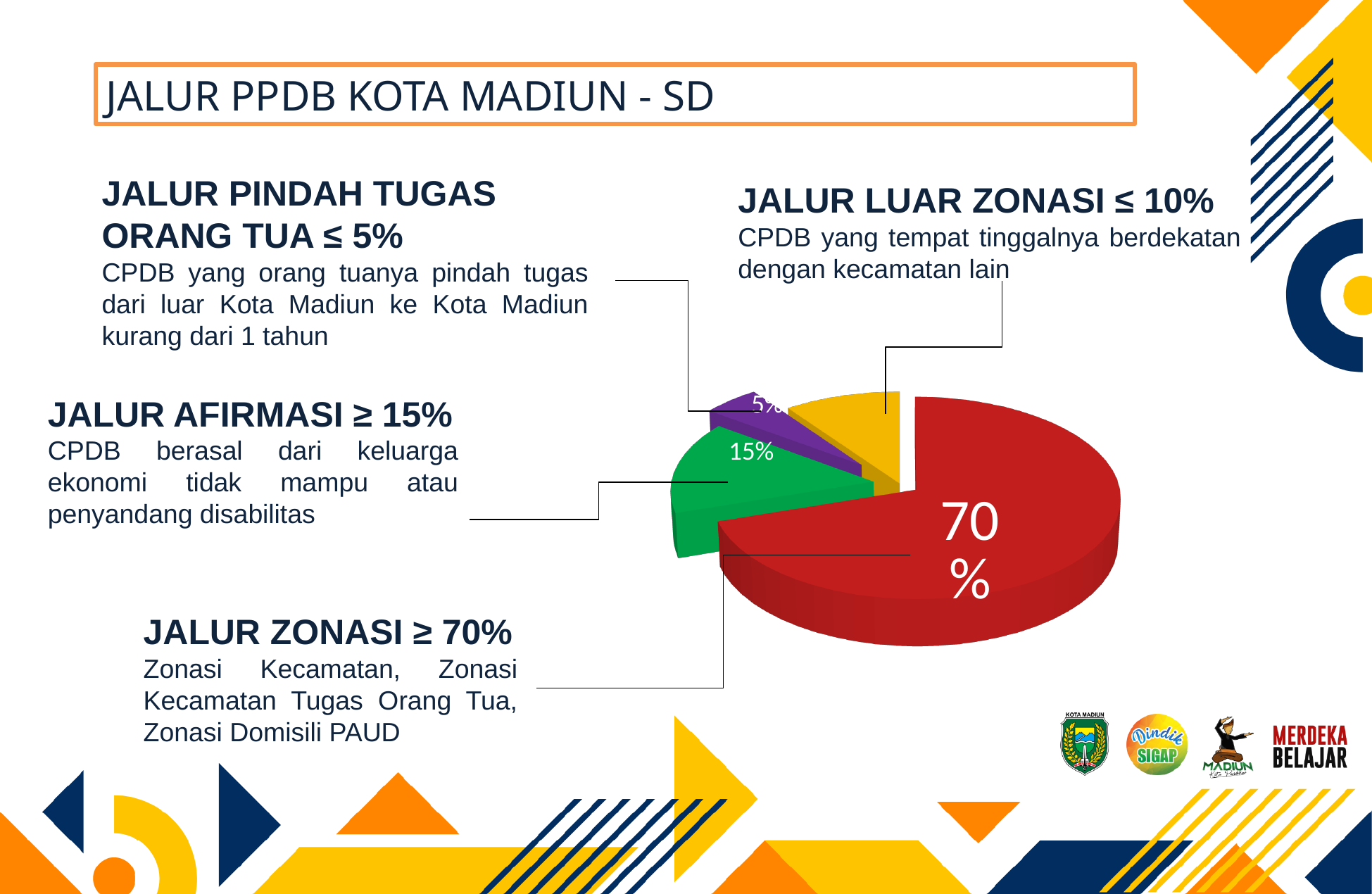
Which slice is larger, the green slice or the purple slice? green slice What percentage is shown on the green slice of the pie chart? 15% What is the difference in percentage points between the green slice and the purple slice? 10 What colour is the slice linked to Jalur Luar Zonasi? yellow How many slices does the pie chart have? 4 What percentage is shown on the purple slice of the pie chart? 5% What is the difference in percentage points between the red slice and the green slice? 55 What share of the pie does the Jalur Zonasi slice represent? 70% What kind of chart is shown on the slide? pie chart What percentage is shown on the red slice of the pie chart? 70% Which jalur (route) corresponds to the smallest slice of the pie chart? Jalur Pindah Tugas Orang Tua Which jalur (route) corresponds to the largest slice of the pie chart? Jalur Zonasi